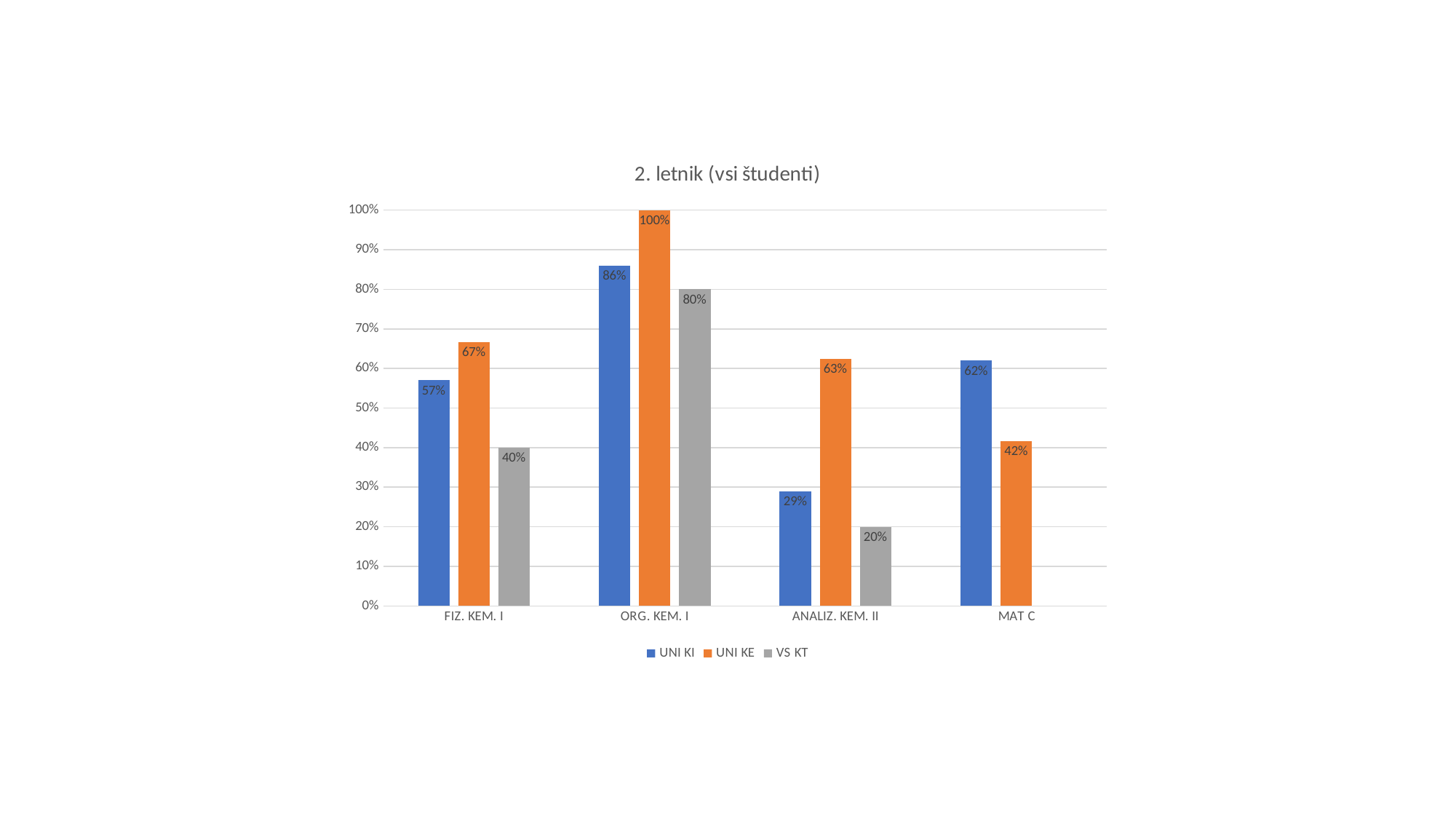
What is the difference between the UNI KE and UNI KI values in ANALIZ. KEM. II? 34% What is the value for UNI KI in ANALIZ. KEM. II? 29% What is the value for VS KT in FIZ. KEM. I? 40% What is the value for UNI KE in ORG. KEM. I? 100% How many series does the legend list? 3 What is the value for UNI KE in MAT C? 42% What is the title of the chart? 2. letnik (vsi študenti) Which is larger in MAT C: UNI KI or UNI KE? UNI KI Which category has the lowest VS KT value? ANALIZ. KEM. II How many categories are shown on the x axis? 4 What kind of chart is this? Bar chart Which category has the highest UNI KI value? ORG. KEM. I